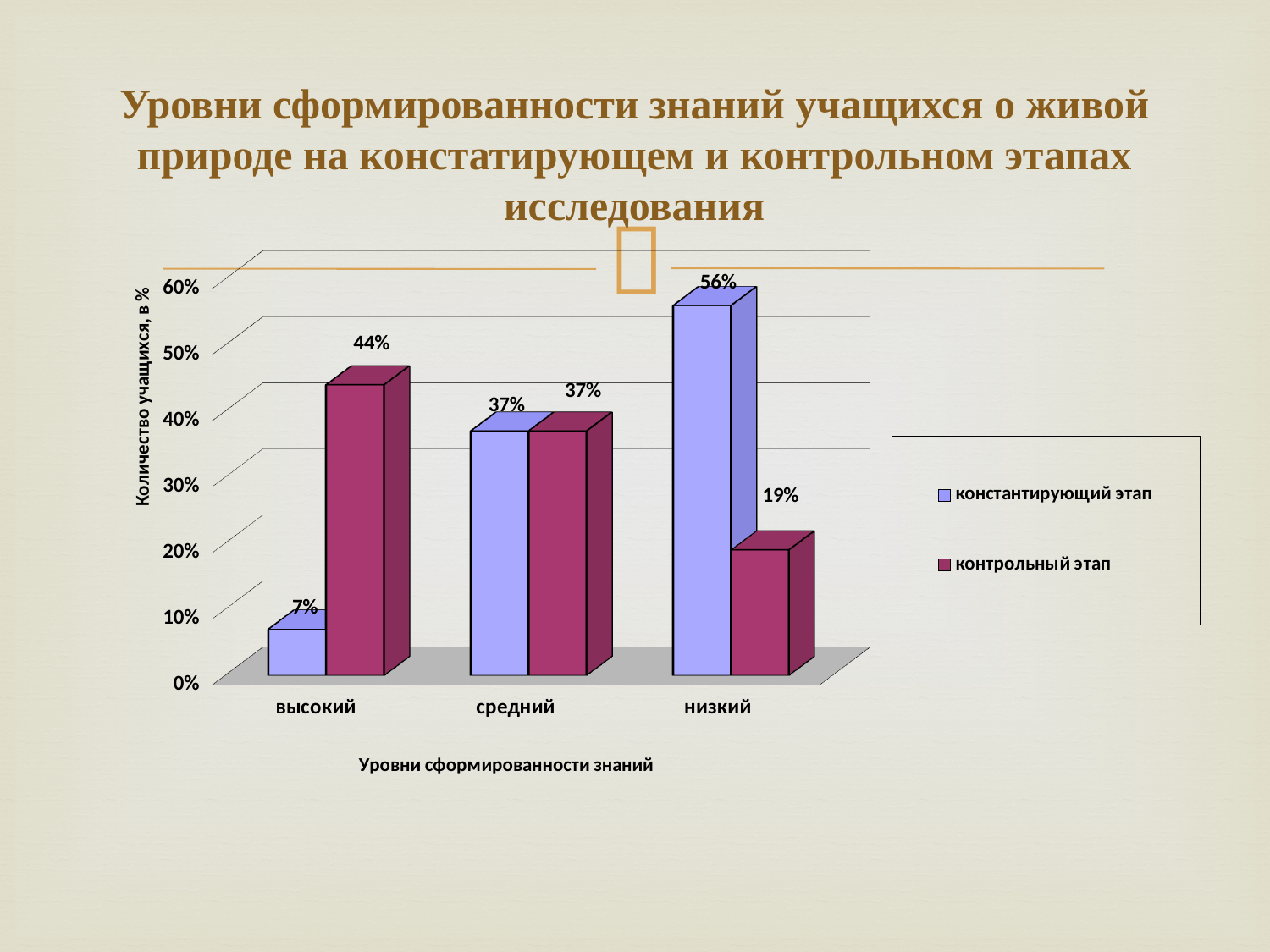
What kind of chart is shown on the slide? bar chart What is the difference between the константирующий этап and контрольный этап values for низкий? 37% What is the value for средний in the константирующий этап series? 37% How many series does the legend list? 2 How many categories are shown on the x axis? 3 What is the label of the y axis? Количество учащихся, в % What is the value for высокий in the контрольный этап series? 44% Which category has the highest value in the константирующий этап series? низкий What is the value for низкий in the контрольный этап series? 19% Which is larger for высокий: the константирующий этап value or the контрольный этап value? контрольный этап Which category has the lowest value in the контрольный этап series? низкий What is the value for высокий in the константирующий этап series? 7%